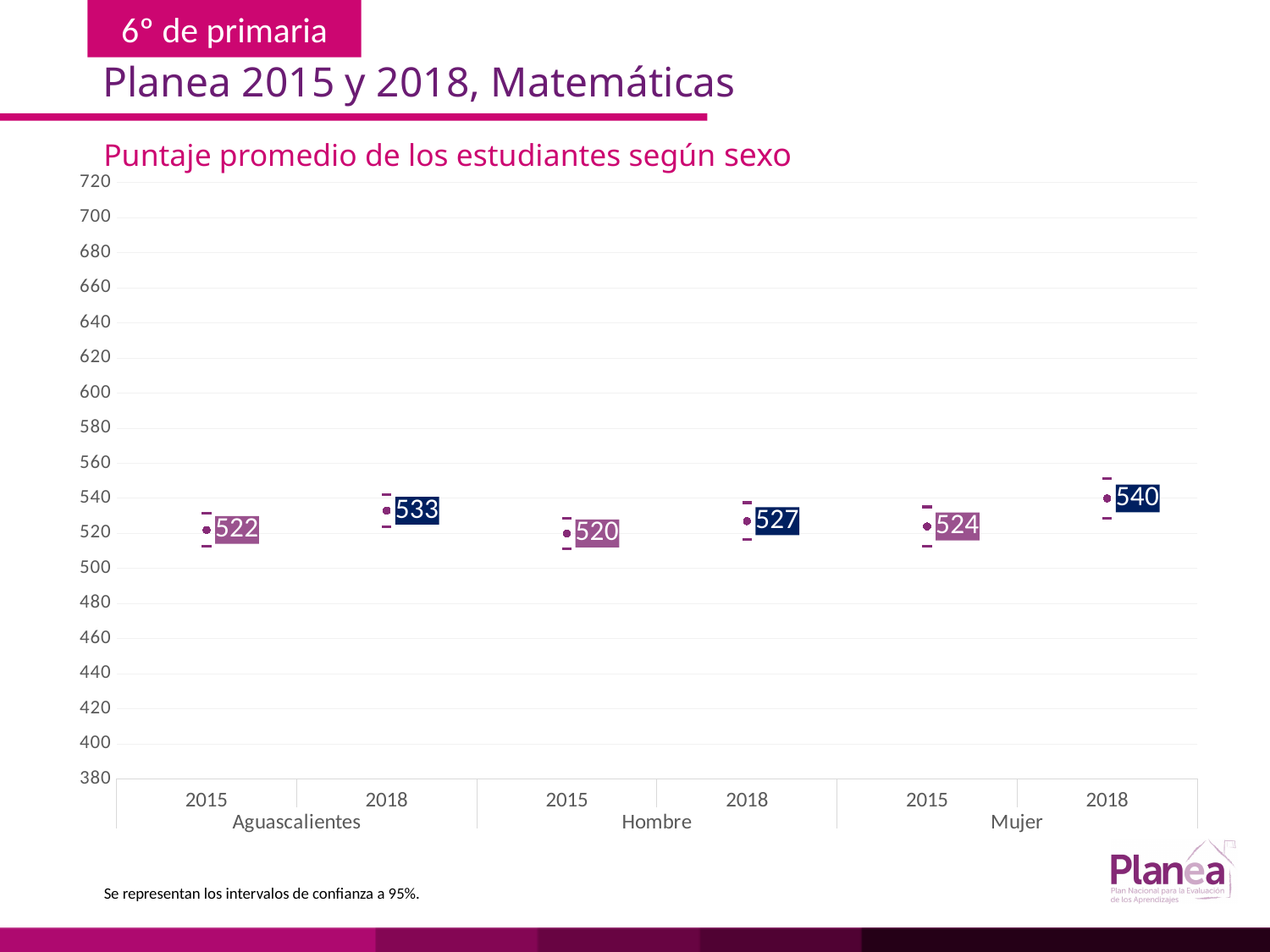
How many data points are plotted on the chart? 6 What is the average score for Mujer in 2018? 540 What is the difference between the Aguascalientes scores in 2018 and 2015? 11 Which group and year has the lowest average score? Hombre 2015 What is the title of the chart? Puntaje promedio de los estudiantes según sexo What is the average score for Aguascalientes in 2018? 533 Which is larger, the Hombre 2018 score or the Mujer 2015 score? Hombre 2018 What is the difference between the Mujer scores in 2018 and 2015? 16 What is the average score for Hombre in 2018? 527 Which group and year has the highest average score? Mujer 2018 What is the average score for Aguascalientes in 2015? 522 What is the average score for Hombre in 2015? 520